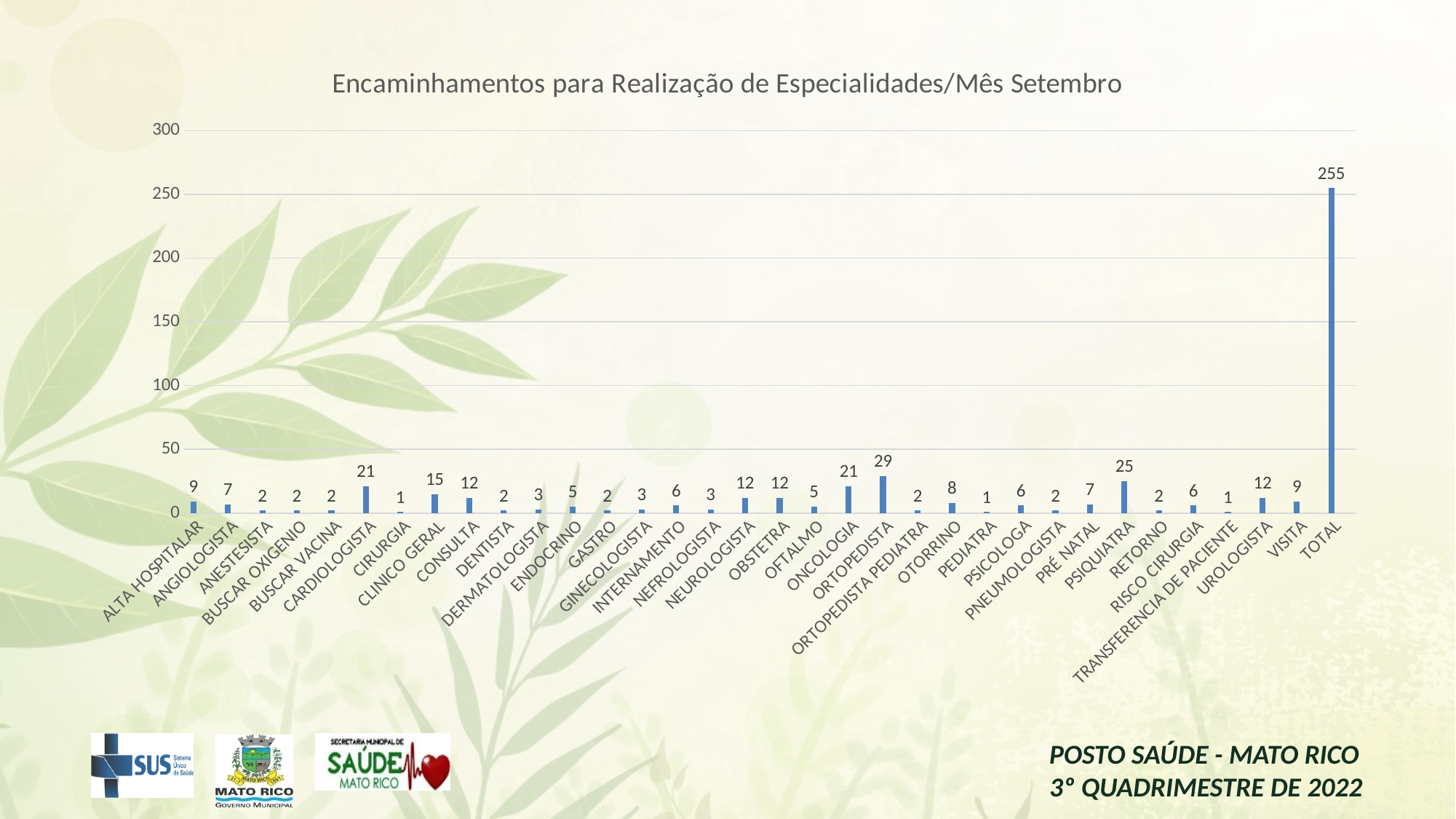
What is the value shown for TOTAL? 255 Excluding the TOTAL bar, which category has the highest value? ORTOPEDISTA How many categories are shown on the x axis, including TOTAL? 34 What is the value for CLINICO GERAL? 15 What is the value for PSIQUIATRA? 25 What kind of chart is shown on the slide? Bar chart What is the value for UROLOGISTA? 12 Is the value for TOTAL greater or less than 250? greater What is the value for ORTOPEDISTA? 29 What is the difference between the values for ORTOPEDISTA and PSIQUIATRA? 4 Which has a larger value, CARDIOLOGISTA or OTORRINO? CARDIOLOGISTA What is the title of the chart? Encaminhamentos para Realização de Especialidades/Mês Setembro